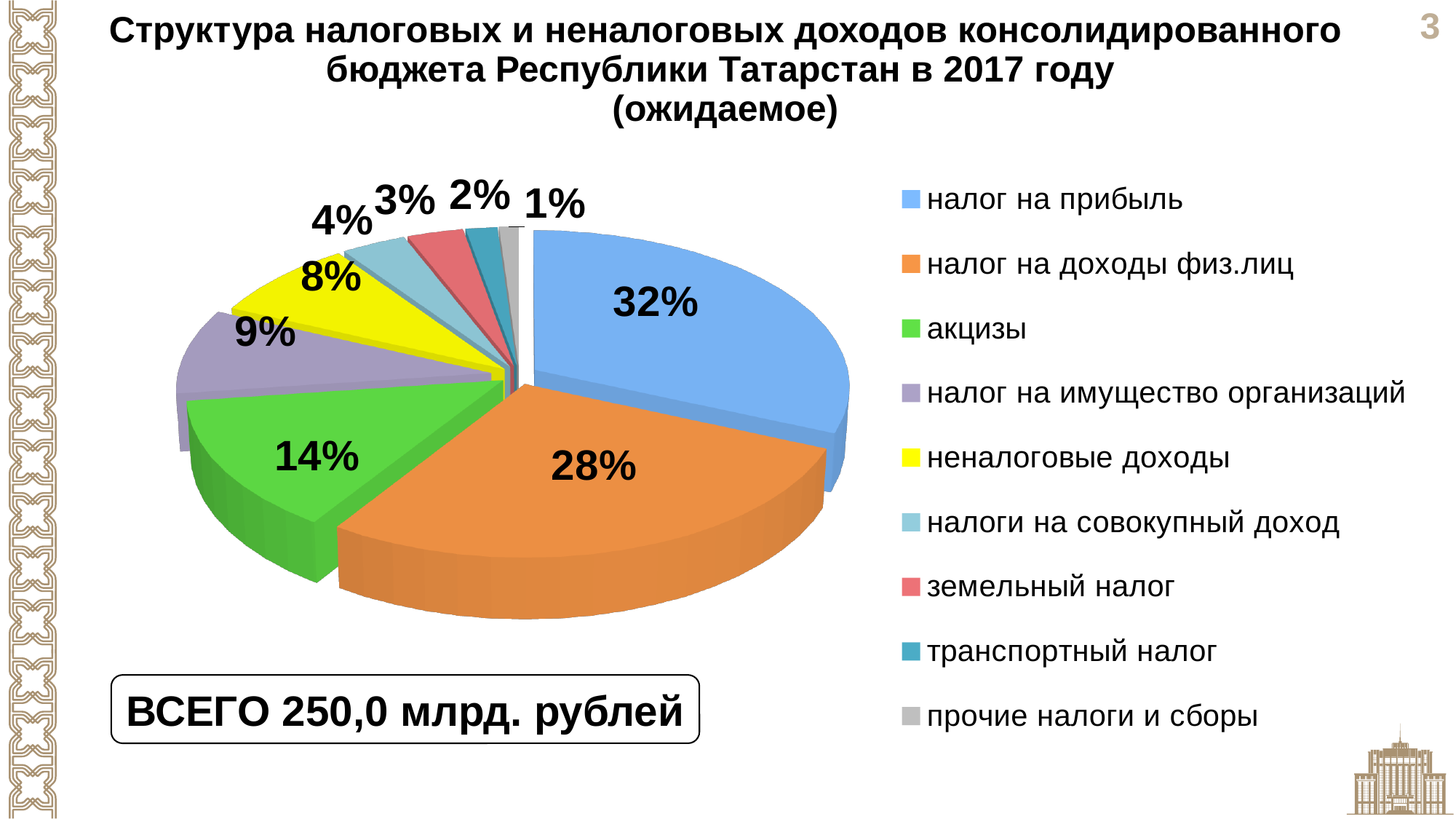
What share is shown for неналоговые доходы? 8% Which category has the largest slice of the pie? налог на прибыль What share of the pie does налог на прибыль account for? 32% What is the value shown for налог на доходы физ.лиц? 28% How many categories does the pie chart show? 9 What percentage is shown for акцизы? 14% What kind of chart is shown on the slide? pie chart What total amount is stated below the chart? 250,0 млрд. рублей Which is larger: налог на имущество организаций or неналоговые доходы? налог на имущество организаций What colour is the slice for земельный налог? red Which category has the smallest slice of the pie? прочие налоги и сборы What is the difference in percentage points between налог на прибыль and налог на доходы физ.лиц? 4